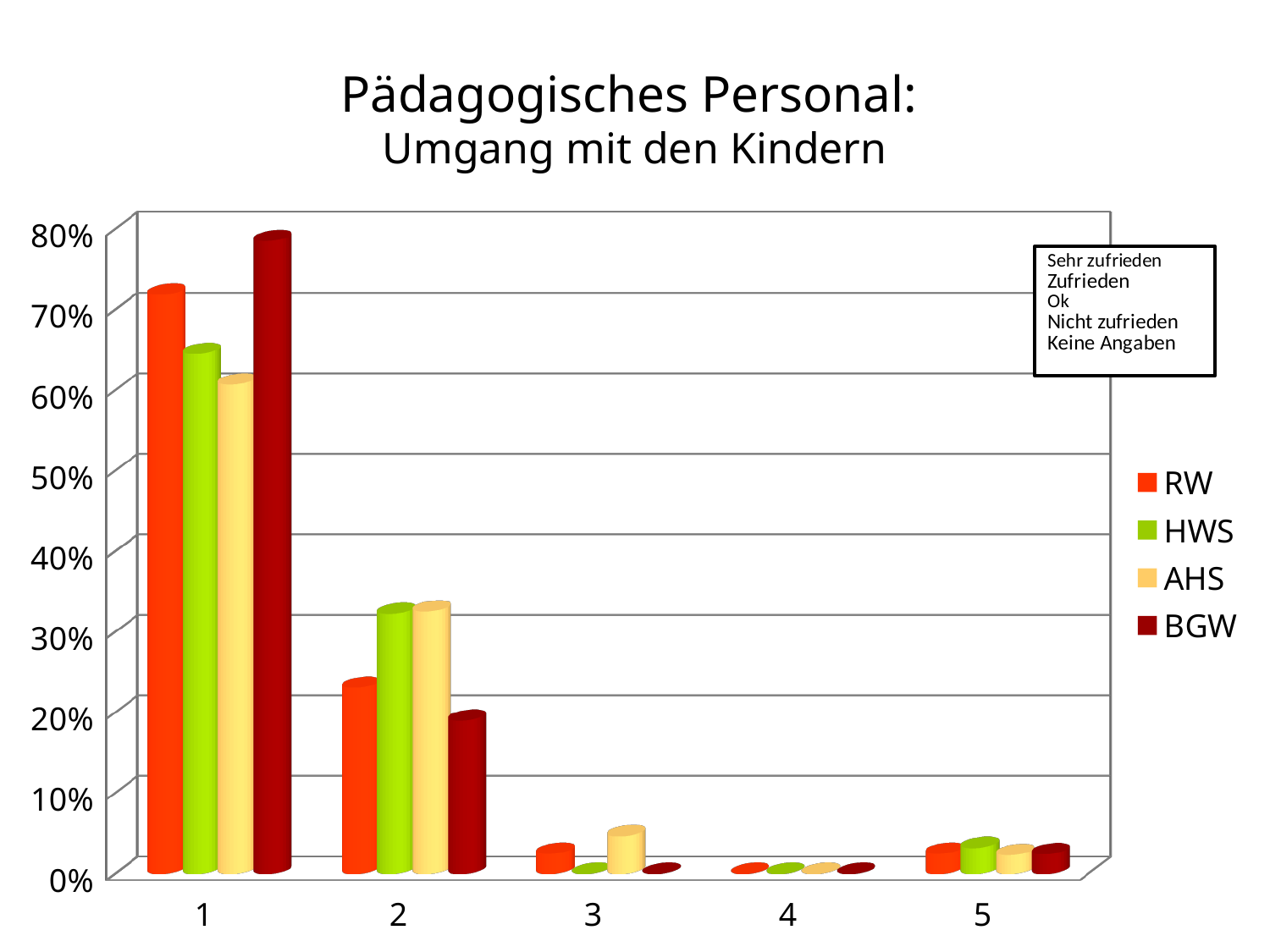
What kind of chart is shown on the slide? bar chart Is the value for BGW in category 1 greater or less than 70%? greater Which series has the highest value in category 1? BGW How many categories are shown on the x axis? 5 Is the value for HWS in category 1 greater or less than 60%? greater Which series has the lowest value in category 2? BGW Which is larger in category 2: the value for HWS or the value for BGW? HWS What is the title of the chart? Pädagogisches Personal: Umgang mit den Kindern Which series has the lowest value in category 1? AHS Do the values for RW rise or fall from category 1 to category 4? fall Is the value for RW in category 2 greater or less than 30%? less How many series does the legend list? 4